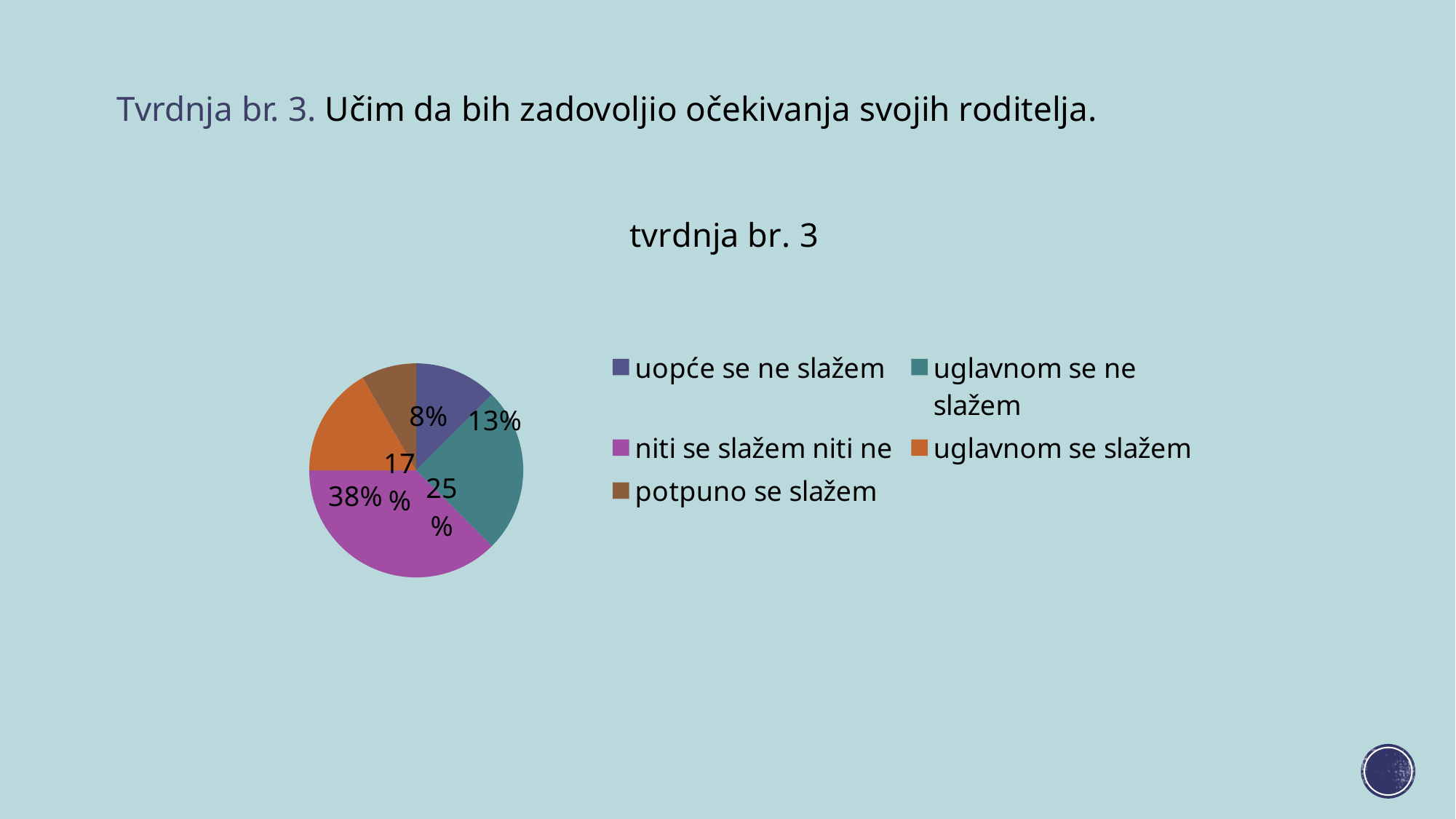
What is the difference in percentage points between the "niti se slažem niti ne" slice and the "uglavnom se ne slažem" slice? 13% What share of the pie does "niti se slažem niti ne" have? 38% What is the title of the chart? tvrdnja br. 3 What share of the pie does "uglavnom se ne slažem" have? 25% How many categories does the legend of the pie chart list? 5 Which category has the smallest slice of the pie? potpuno se slažem What share of the pie does "uopće se ne slažem" have? 13% What kind of chart is shown on the slide? pie chart Which is larger, the slice for "uglavnom se ne slažem" or the slice for "uglavnom se slažem"? uglavnom se ne slažem Which category has the largest slice of the pie? niti se slažem niti ne